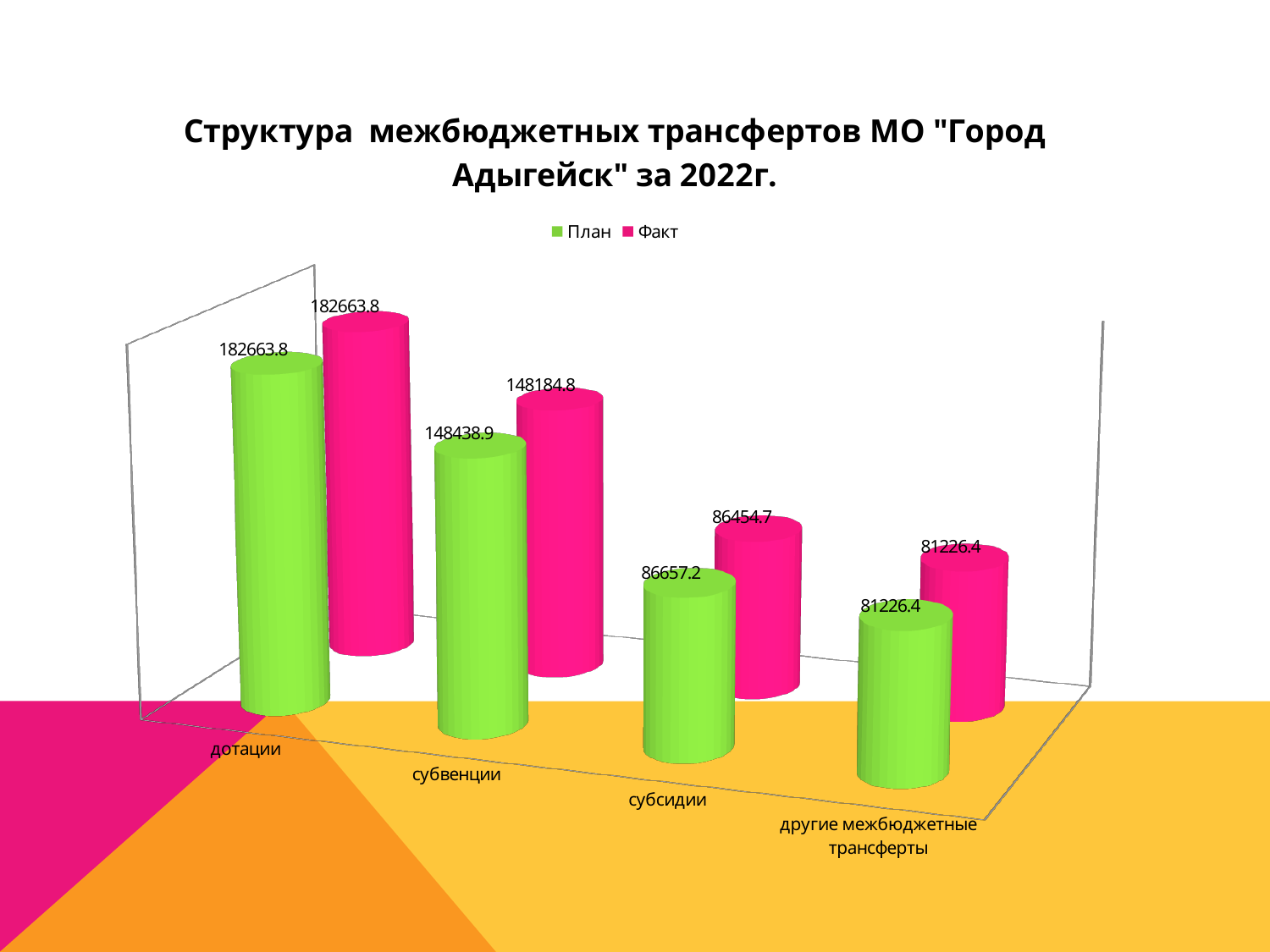
What kind of chart is shown on the slide? bar chart What is the difference between the План values for дотации and субвенции? 34224.9 For субсидии, which is larger: the План value or the Факт value? План What is the План value for другие межбюджетные трансферты? 81226.4 What is the difference between the План and Факт values for субвенции? 254.1 Which category has the highest План value? дотации How many categories are shown on the x axis? 4 What is the Факт value for дотации? 182663.8 What is the Факт value for субсидии? 86454.7 How many series does the legend list? 2 Which category has the lowest Факт value? другие межбюджетные трансферты What is the План value for субвенции? 148438.9